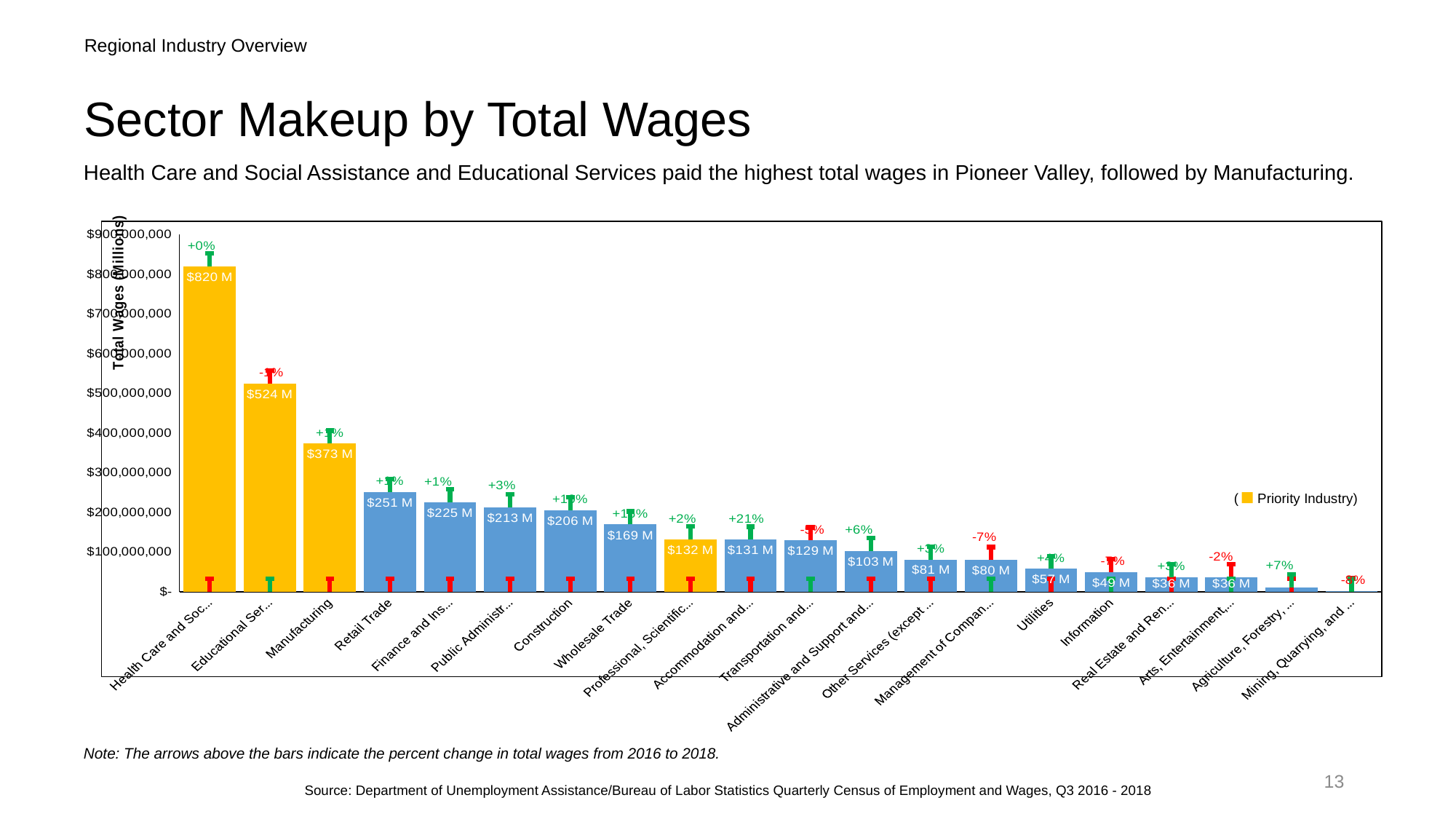
Which has higher total wages, Construction or Wholesale Trade? Construction What is the total wages value for Retail Trade? $251 M Is the total wages value for Agriculture, Forestry greater or less than $100,000,000? less Which sector has the highest total wages? Health Care and Social Assistance What is the total wages value for Utilities? $57 M What is the difference in total wages between Health Care and Social Assistance and Educational Services? $296 M Do the total wages values rise or fall from left to right along the x axis? fall How many sectors are shown in the chart? 20 How many bars are coloured yellow as Priority Industry? 4 What is the total wages value for Manufacturing? $373 M What is the difference in total wages between Educational Services and Manufacturing? $151 M What kind of chart is shown on the slide? bar chart